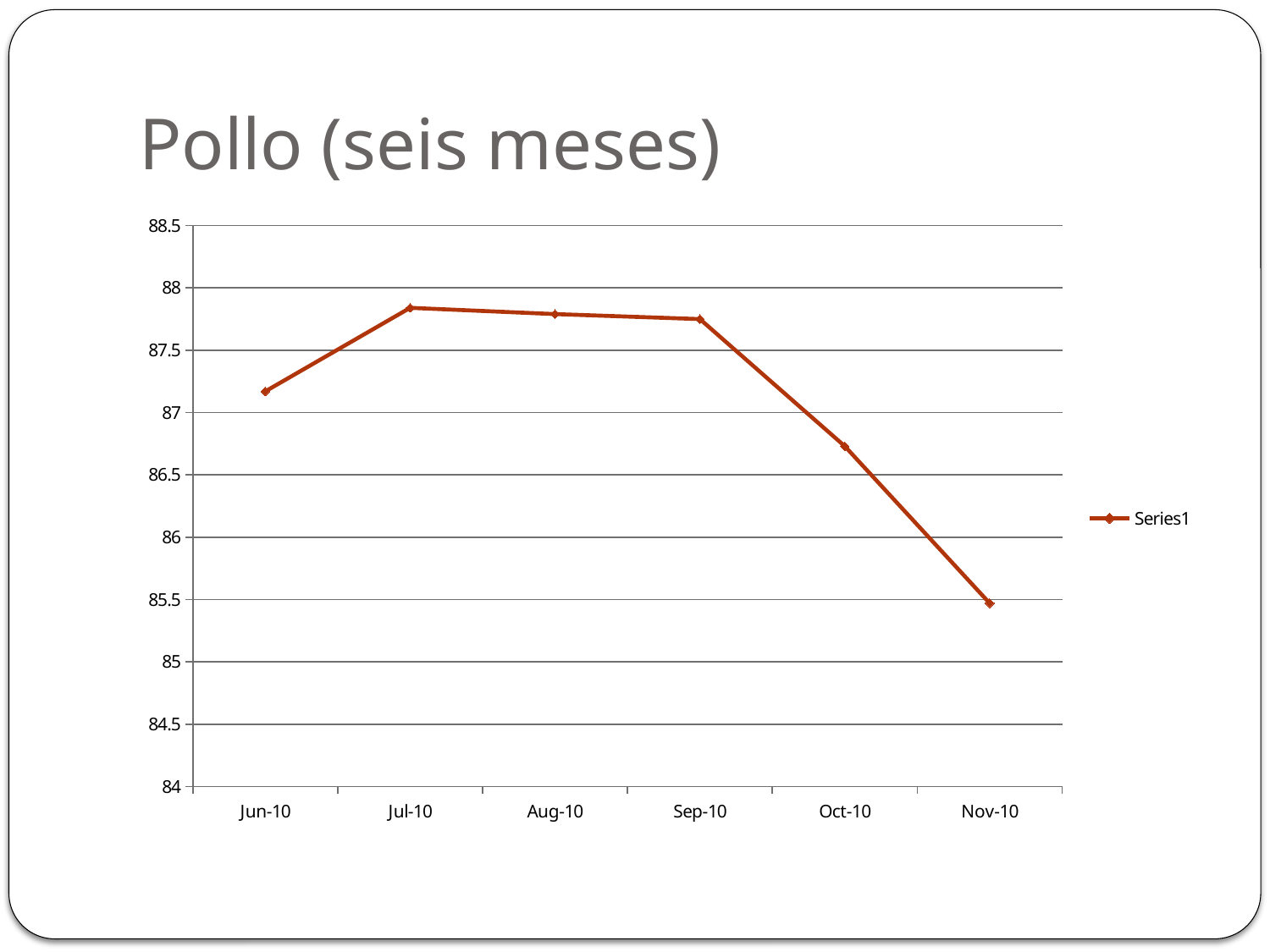
What kind of chart is shown on the slide? line chart Is the value for Jul-10 greater or less than 88? less What is the name of the series shown in the legend? Series1 How many data points are plotted on the chart? 6 How many series does the legend list? 1 What is the title of the chart? Pollo (seis meses) Is the value for Nov-10 greater or less than 86? less Is the value for Jun-10 greater or less than 87? greater Which month has the lowest value? Nov-10 Which is larger, the value for Jun-10 or the value for Oct-10? Jun-10 Do the values rise or fall from Sep-10 to Nov-10? fall